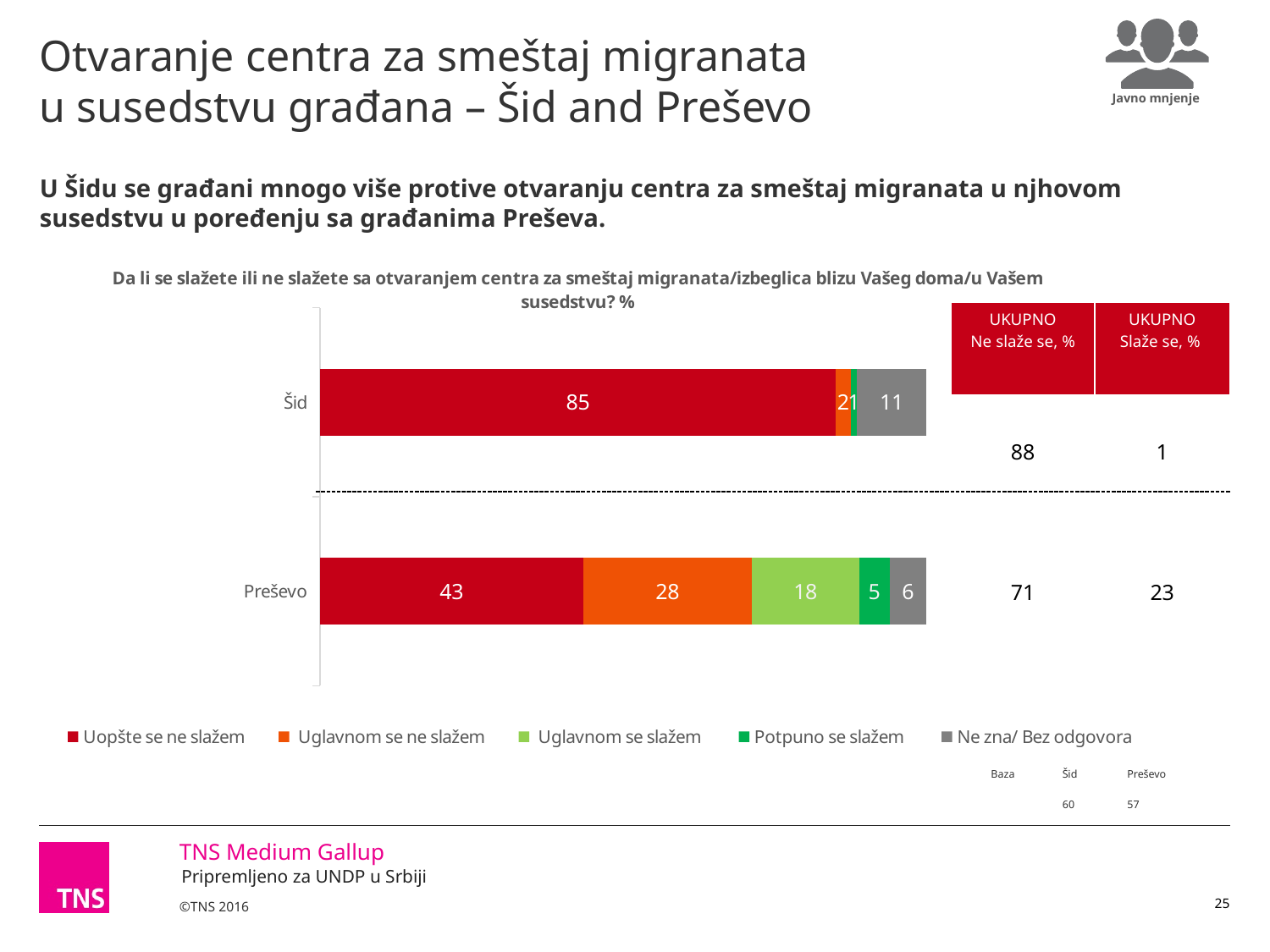
How many categories (places) are plotted in the chart? 2 What is the value for "Uglavnom se ne slažem" for Preševo? 28 What kind of chart is shown on the slide? Stacked bar chart What is the value for "Uglavnom se slažem" for Preševo? 18 What is the difference between the "Uopšte se ne slažem" values for Šid and Preševo? 42 What is the value for "Uopšte se ne slažem" for Šid? 85 Which place has the larger value for "Uopšte se ne slažem", Šid or Preševo? Šid What is the "UKUPNO Slaže se, %" value shown for Šid? 1 What is the "UKUPNO Ne slaže se, %" value shown for Preševo? 71 How many series does the chart legend list? 5 What is the value for "Uopšte se ne slažem" for Preševo? 43 What is the value for "Ne zna/ Bez odgovora" for Šid? 11